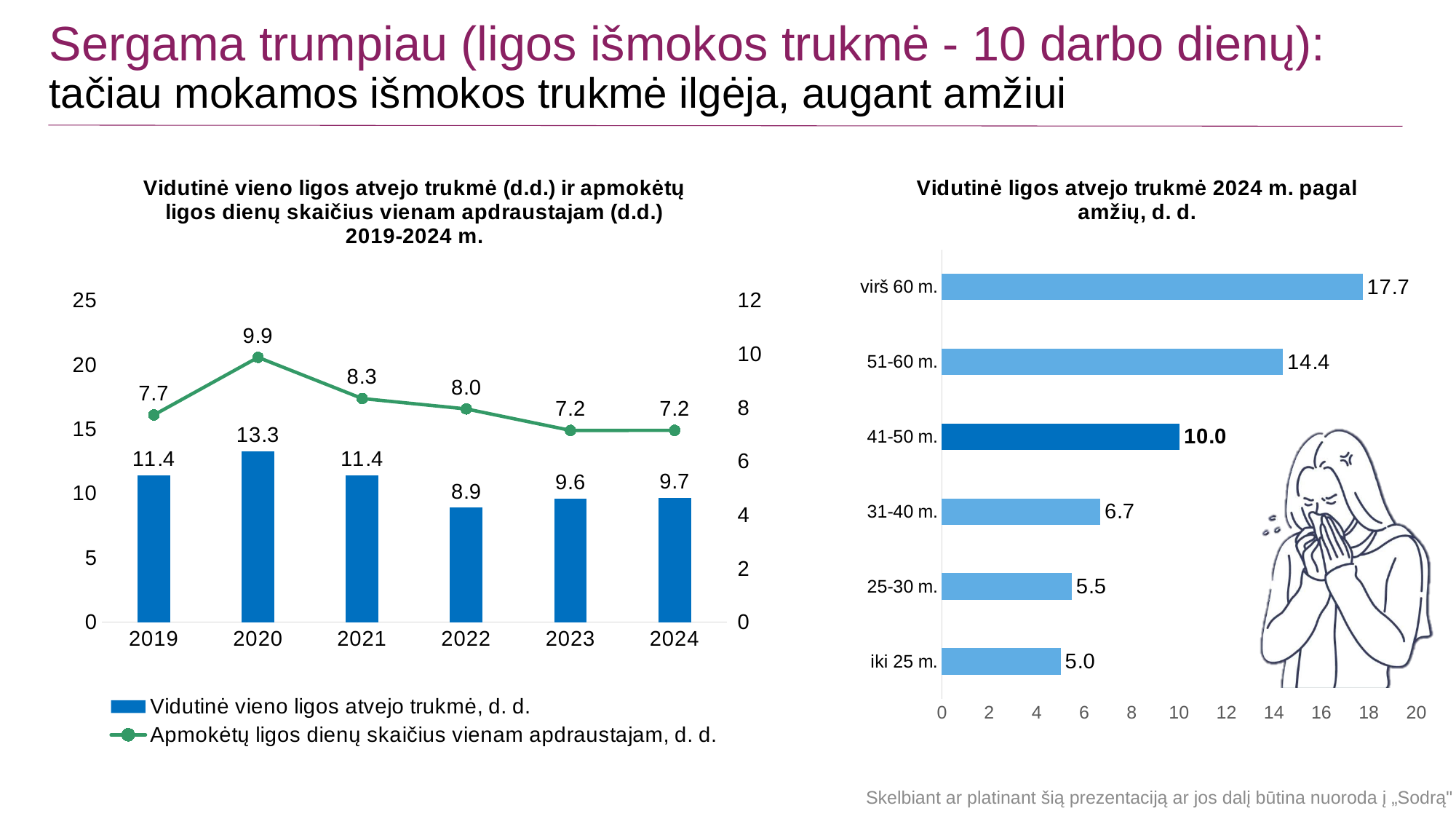
In the left chart (2019-2024), which year has the highest value for 'Vidutinė vieno ligos atvejo trukmė, d. d.'? 2020 In the left chart (2019-2024), what is the difference between the 'Vidutinė vieno ligos atvejo trukmė' values for 2020 and 2024? 3.6 In the right chart (2024 by age), which age group has the highest value? virš 60 m. In the right chart (2024 by age), which age group has the lowest value? iki 25 m. In the left chart (2019-2024), does the 'Apmokėtų ligos dienų skaičius vienam apdraustajam' line rise or fall from 2020 to 2024? fall In the left chart (2019-2024), what is the value of 'Apmokėtų ligos dienų skaičius vienam apdraustajam, d. d.' for 2023? 7.2 In the right chart (2024 by age), what is the difference between the values for 'virš 60 m.' and '41-50 m.'? 7.7 In the right chart (2024 by age), what is the value for '51-60 m.'? 14.4 What kind of chart is the right chart (2024 by age)? bar chart In the left chart (2019-2024), how many series does the legend list? 2 In the left chart (2019-2024), what is the value of 'Vidutinė vieno ligos atvejo trukmė, d. d.' for 2020? 13.3 In the left chart (2019-2024), which year has the lowest value for 'Vidutinė vieno ligos atvejo trukmė, d. d.'? 2022